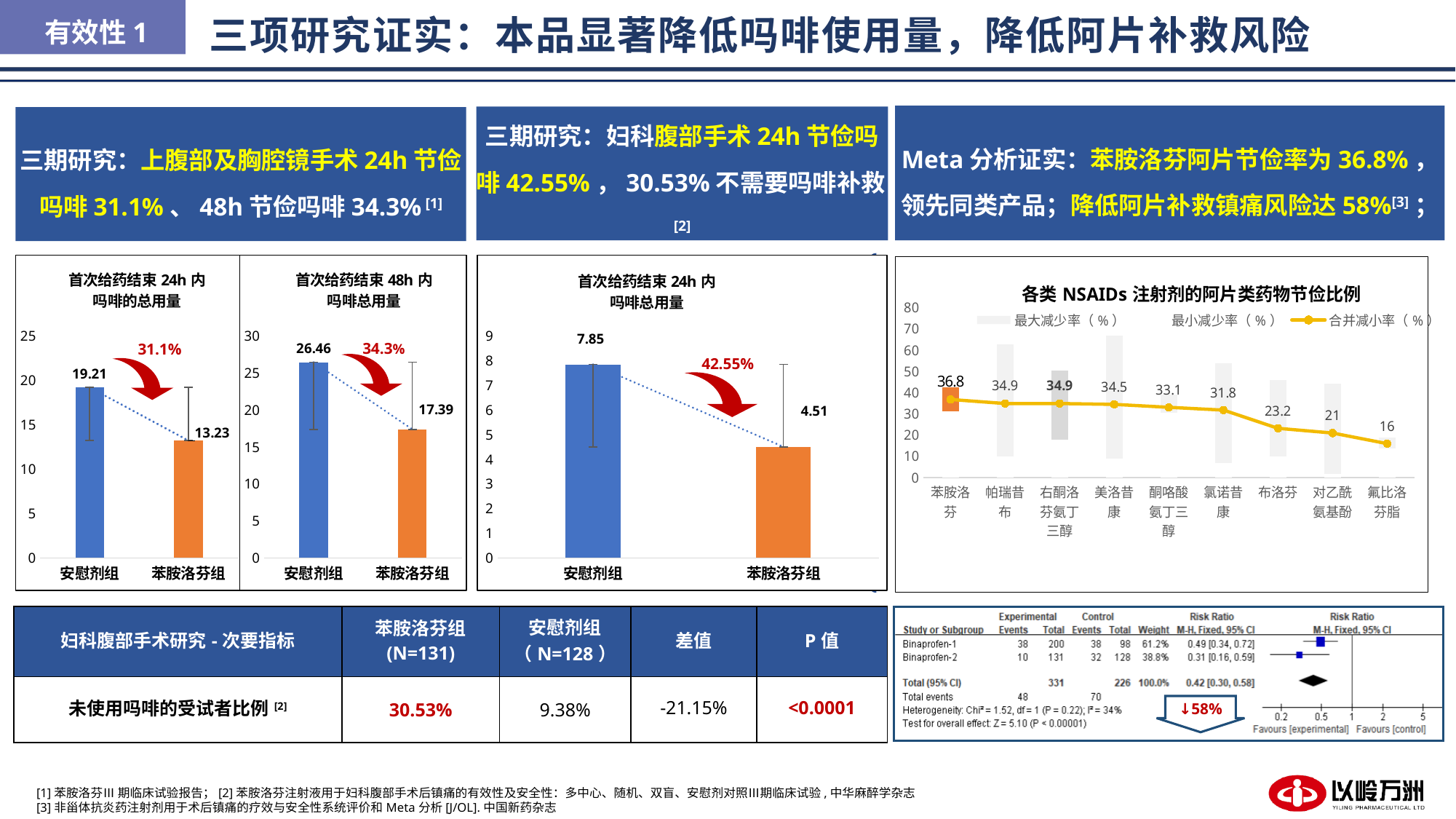
In the chart 各类NSAIDs注射剂的阿片类药物节俭比例, which drug has the lowest 合并减小率? 氟比洛芬脂 In the second chart from the left (首次给药结束48h内吗啡总用量), which group has the lower value? 苯胺洛芬组 In the chart 各类NSAIDs注射剂的阿片类药物节俭比例, what is the 合并减小率 value for 苯胺洛芬? 36.8 In the leftmost chart (首次给药结束24h内吗啡的总用量), what is the value for 安慰剂组? 19.21 In the middle chart (首次给药结束24h内吗啡总用量, gynecological study), what is the value for 苯胺洛芬组? 4.51 In the second chart from the left (首次给药结束48h内吗啡总用量), what percentage reduction is shown by the red arrow? 34.3% In the leftmost chart (首次给药结束24h内吗啡的总用量), what is the difference between 安慰剂组 and 苯胺洛芬组? 5.98 In the leftmost chart (首次给药结束24h内吗啡的总用量), what is the value for 苯胺洛芬组? 13.23 In the middle chart (首次给药结束24h内吗啡总用量, gynecological study), what is the difference between 安慰剂组 and 苯胺洛芬组? 3.34 In the chart 各类NSAIDs注射剂的阿片类药物节俭比例, how many series does the legend list? 3 In the second chart from the left (首次给药结束48h内吗啡总用量), what is the value for 安慰剂组? 26.46 In the chart 各类NSAIDs注射剂的阿片类药物节俭比例, how many drugs are shown on the x axis? 9